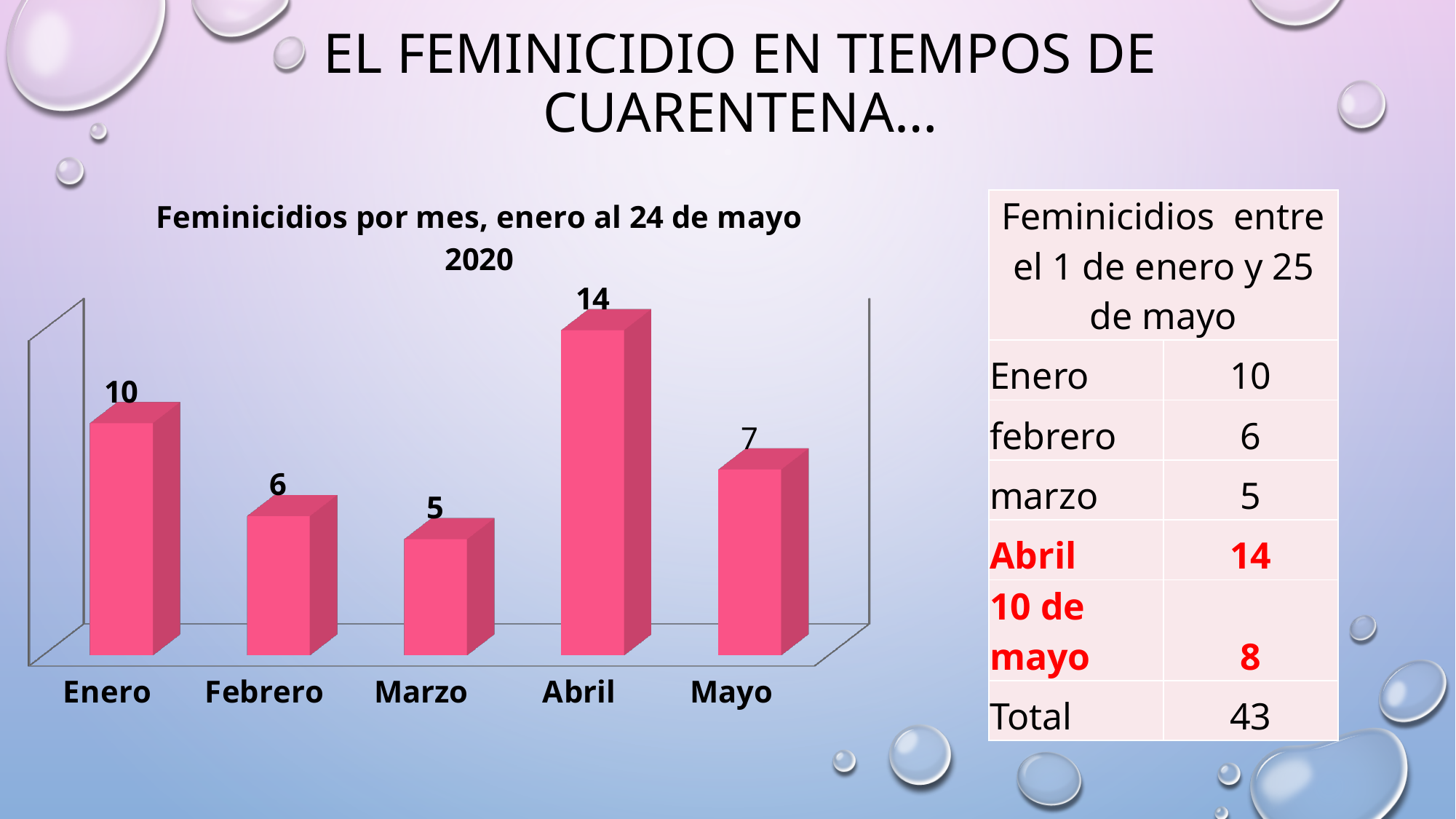
Which is larger, the value for Mayo or the value for Febrero? Mayo What is the value for Abril in the chart? 14 What is the title of the chart? Feminicidios por mes, enero al 24 de mayo 2020 What is the difference between the values for Enero and Febrero? 4 What kind of chart is shown on the slide? Bar chart What is the value for Mayo in the chart? 7 Do the values rise or fall from Enero to Marzo? Fall Which month has the highest value in the chart? Abril What is the difference between the values for Abril and Marzo? 9 What is the value for Enero in the chart? 10 Which month has the lowest value in the chart? Marzo How many months are shown in the chart? 5